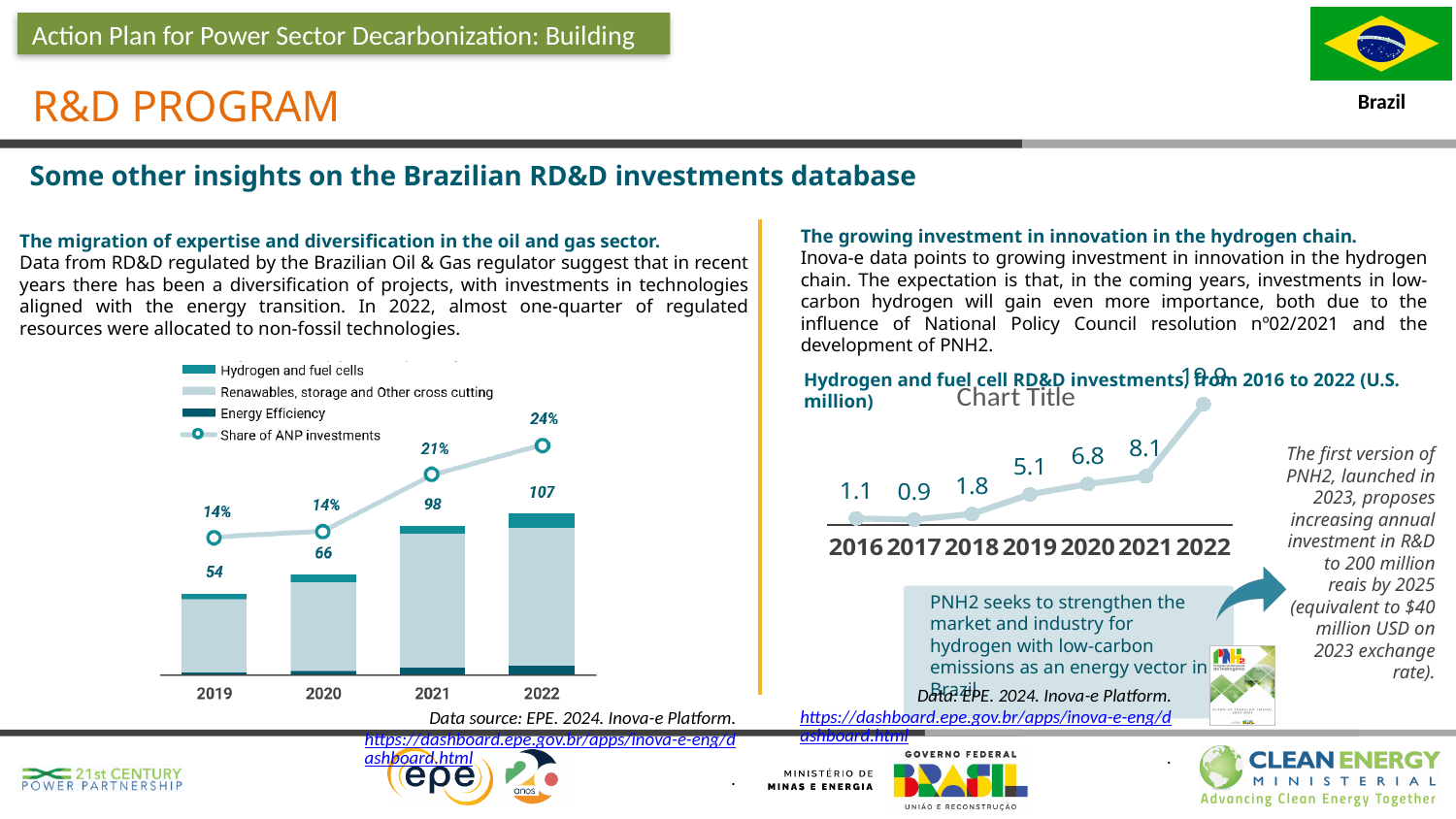
On the left chart, what is the difference between the total values for 2021 and 2020? 32 On the right chart (Hydrogen and fuel cell RD&D investments), what is the difference between the values for 2021 and 2020? 1.3 On the left chart, what is the Share of ANP investments in 2021? 21% On the left chart, what is the total value labeled for 2022? 107 On the right chart (Hydrogen and fuel cell RD&D investments), which year has the lowest value? 2017 What kind of chart is the right chart (Hydrogen and fuel cell RD&D investments)? Line chart On the left chart, how many years are shown on the x axis? 4 On the right chart (Hydrogen and fuel cell RD&D investments), what is the value for 2019? 5.1 On the right chart (Hydrogen and fuel cell RD&D investments), what is the value for 2017? 0.9 On the left chart, what is the total value labeled for 2019? 54 On the left chart, which year has the highest Share of ANP investments? 2022 On the left chart, how many series does the legend list? 4